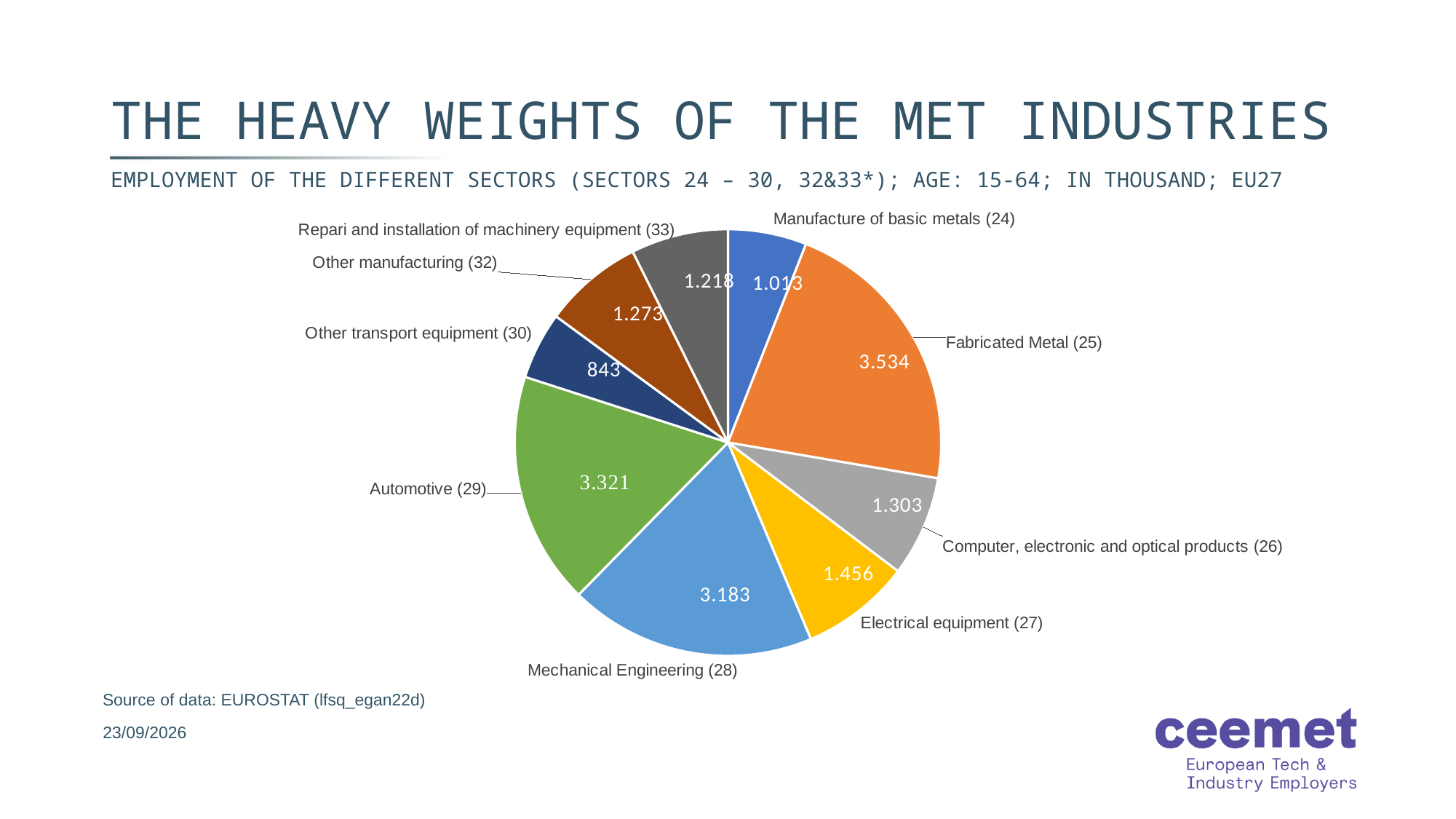
What is the employment value shown for Fabricated Metal (25)? 3.534 Which sector has the smallest slice of the pie? Other transport equipment (30) What is the employment value shown for Electrical equipment (27)? 1.456 Which is larger, the value for Automotive (29) or the value for Mechanical Engineering (28)? Automotive (29) What is the title of the slide containing the pie chart? THE HEAVY WEIGHTS OF THE MET INDUSTRIES What is the employment value shown for Automotive (29)? 3.321 What is the difference between the values for Fabricated Metal (25) and Mechanical Engineering (28)? 351 What is the employment value shown for Other transport equipment (30)? 843 What is the difference between the values for Electrical equipment (27) and Computer, electronic and optical products (26)? 153 What kind of chart is shown on the slide? pie chart Which sector has the largest slice of the pie? Fabricated Metal (25) How many sectors (slices) does the pie chart show? 9